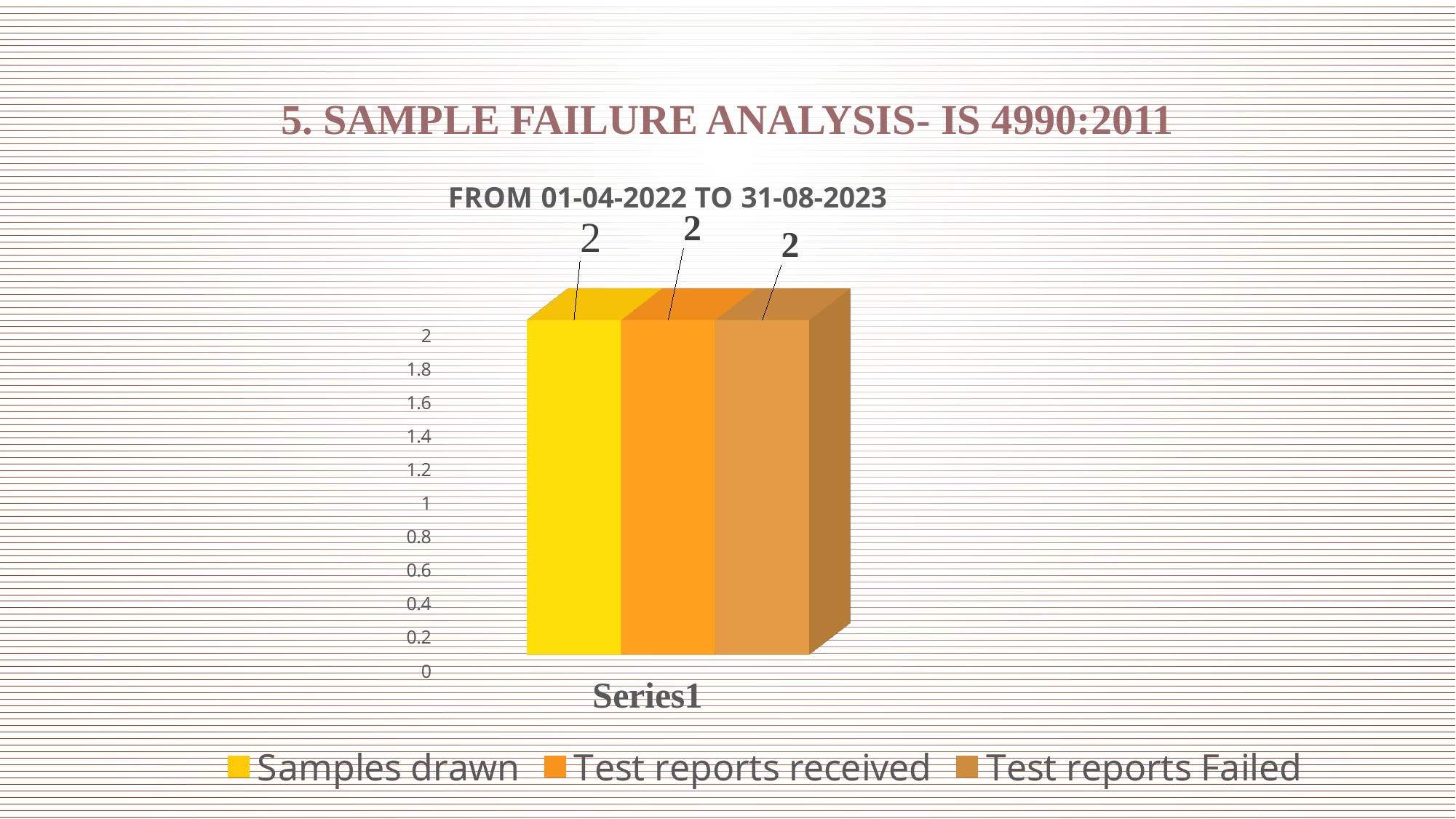
What is the value for Test reports received? 2 How many categories are shown on the x axis? 1 What is the difference between the value for Samples drawn and the value for Test reports Failed? 0 How many series does the legend list? 3 What is the label of the category on the x axis? Series1 What is the title of the chart? FROM 01-04-2022 TO 31-08-2023 What is the value for Samples drawn? 2 What is the value for Test reports Failed? 2 Is the value for Test reports received greater or less than 1? greater What kind of chart is shown on the slide? Bar chart